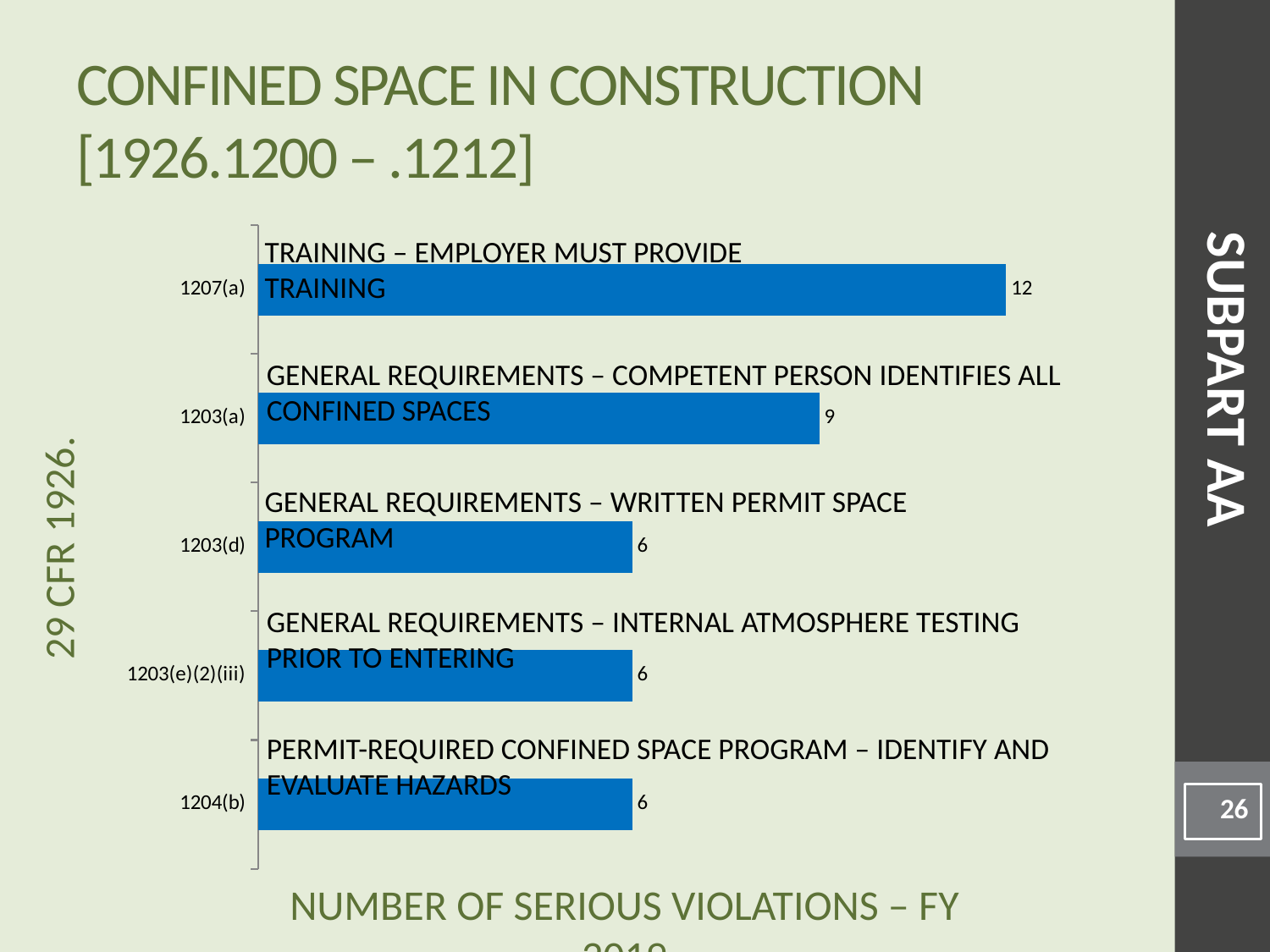
What is the difference in serious violations between 1203(a) and 1203(d)? 3 Which standard has the highest number of serious violations? 1207(a) What colour are the bars in the chart? Blue What is the description shown for the 1207(a) bar? TRAINING – EMPLOYER MUST PROVIDE TRAINING What is the number of serious violations for 1204(b)? 6 What type of chart is shown on the slide? Bar chart What is the number of serious violations for 1207(a)? 12 What is the number of serious violations for 1203(d)? 6 What is the number of serious violations for 1203(a)? 9 Which has more serious violations, 1203(a) or 1203(e)(2)(iii)? 1203(a) How many standards (categories) are shown in the chart? 5 What is the difference in serious violations between 1207(a) and 1203(a)? 3